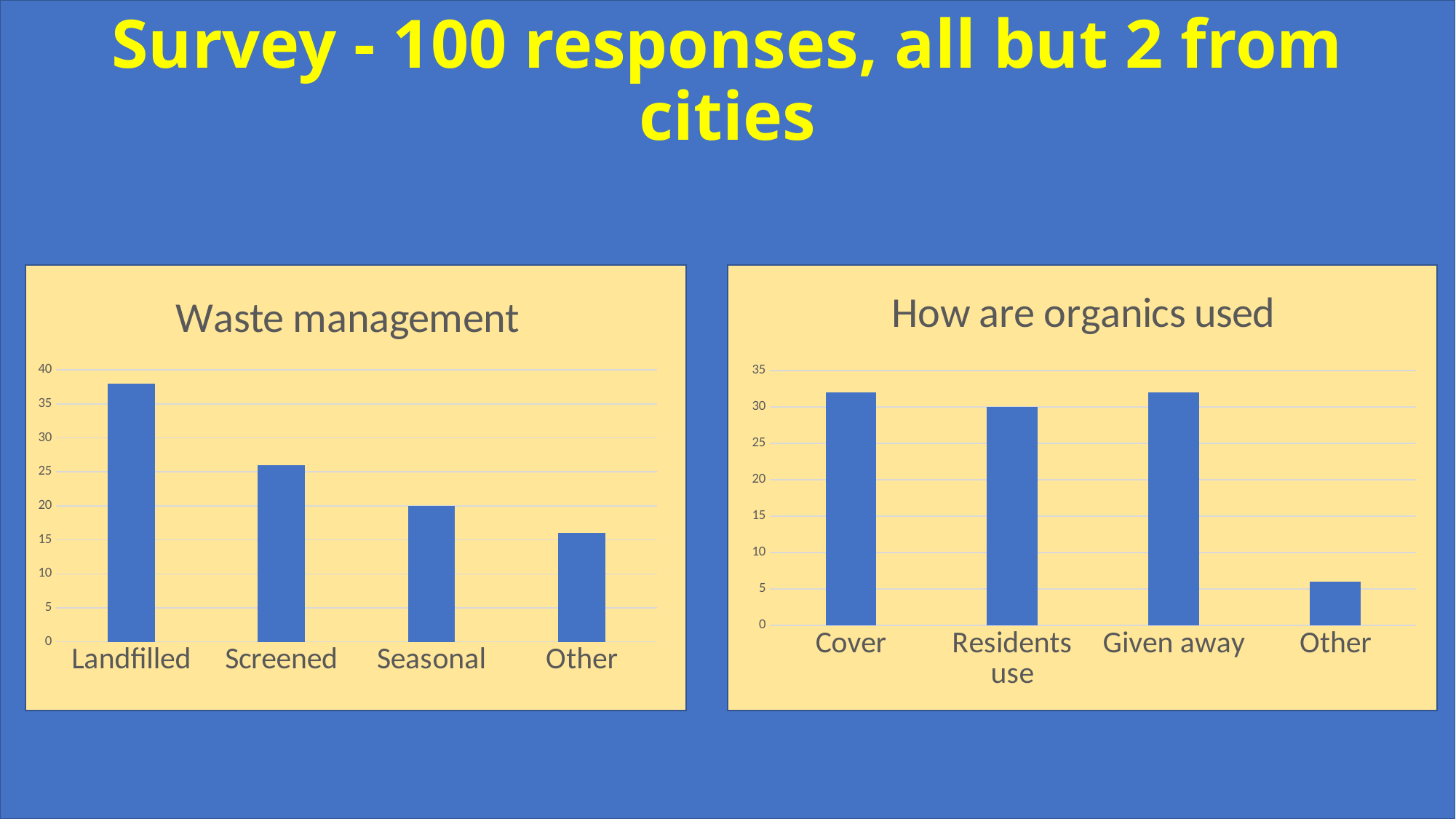
In the "How are organics used" chart, what is the value for Residents use? 30 In the "Waste management" chart, which category has the highest value? Landfilled In the "How are organics used" chart, which is larger, Cover or Residents use? Cover In the "Waste management" chart, is the value for Landfilled greater or less than 35? greater In the "Waste management" chart, is the value for Screened greater or less than 30? less How many categories are shown in the "Waste management" chart? 4 In the "How are organics used" chart, which category has the lowest value? Other In the "How are organics used" chart, is the value for Other greater or less than 10? less In the "Waste management" chart, which category has the lowest value? Other In the "Waste management" chart, do the values rise or fall from left to right? fall What type of chart is the "Waste management" chart? bar chart In the "Waste management" chart, what is the value for Seasonal? 20